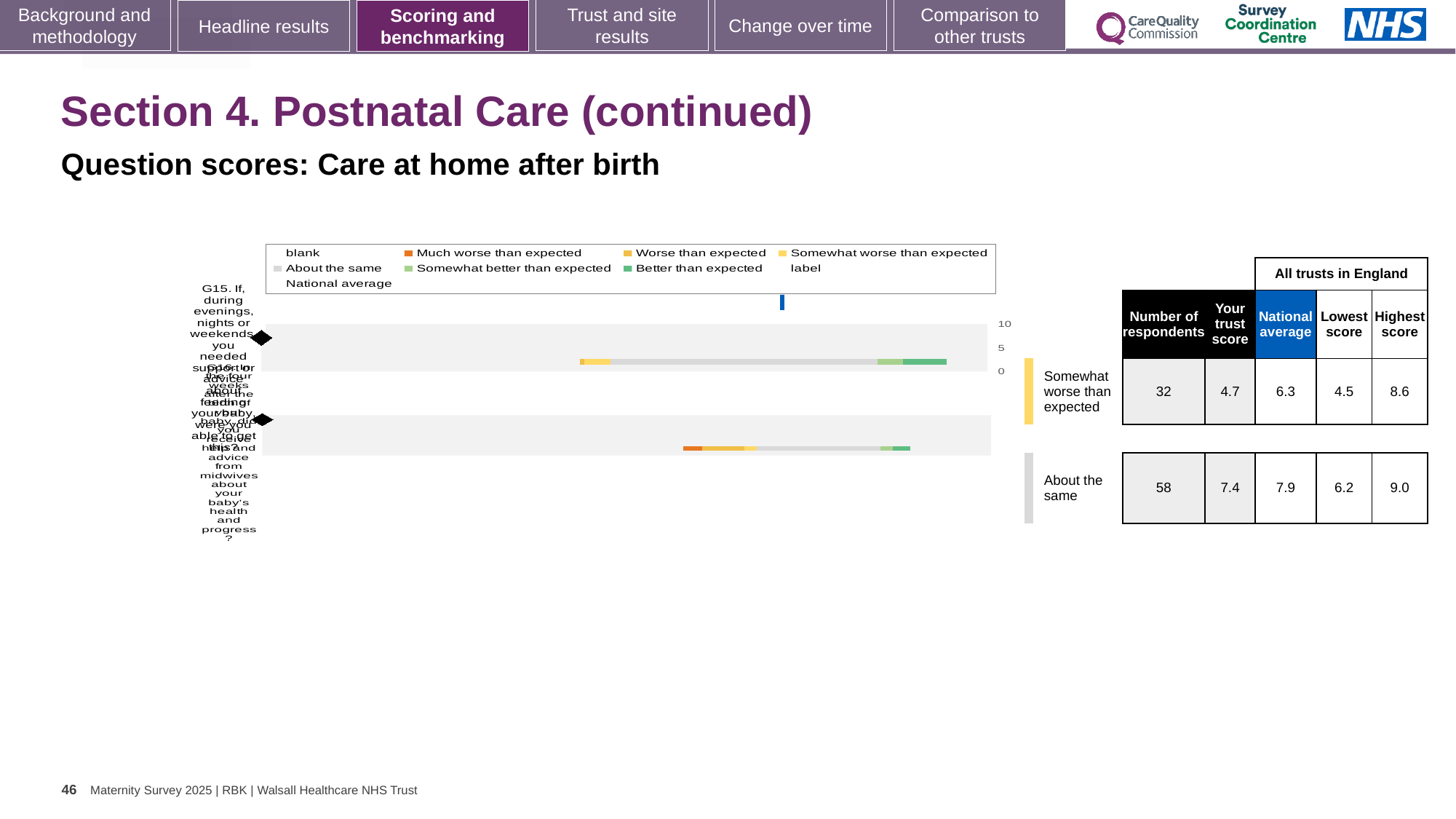
What kind of chart is shown on the slide? Bar chart What is the difference between the highest and lowest scores for the second bar, rated 'About the same'? 2.8 By how much is the national average higher than the trust score for the first bar, rated 'Somewhat worse than expected'? 1.6 How many respondents answered the question shown in the first bar? 32 Which bar has the higher trust score, the one rated 'Somewhat worse than expected' or the one rated 'About the same'? About the same What is the national average for the second bar, rated 'About the same'? 7.9 What is the lowest score among all trusts in England for the first bar, rated 'Somewhat worse than expected'? 4.5 What colour does the legend use for 'Better than expected'? Green What is the trust score for the first bar, rated 'Somewhat worse than expected'? 4.7 How many bars (question rows) are plotted in the chart? 2 What is the highest score among all trusts in England for the second bar, rated 'About the same'? 9.0 What benchmark rating is given to the first bar in the chart? Somewhat worse than expected